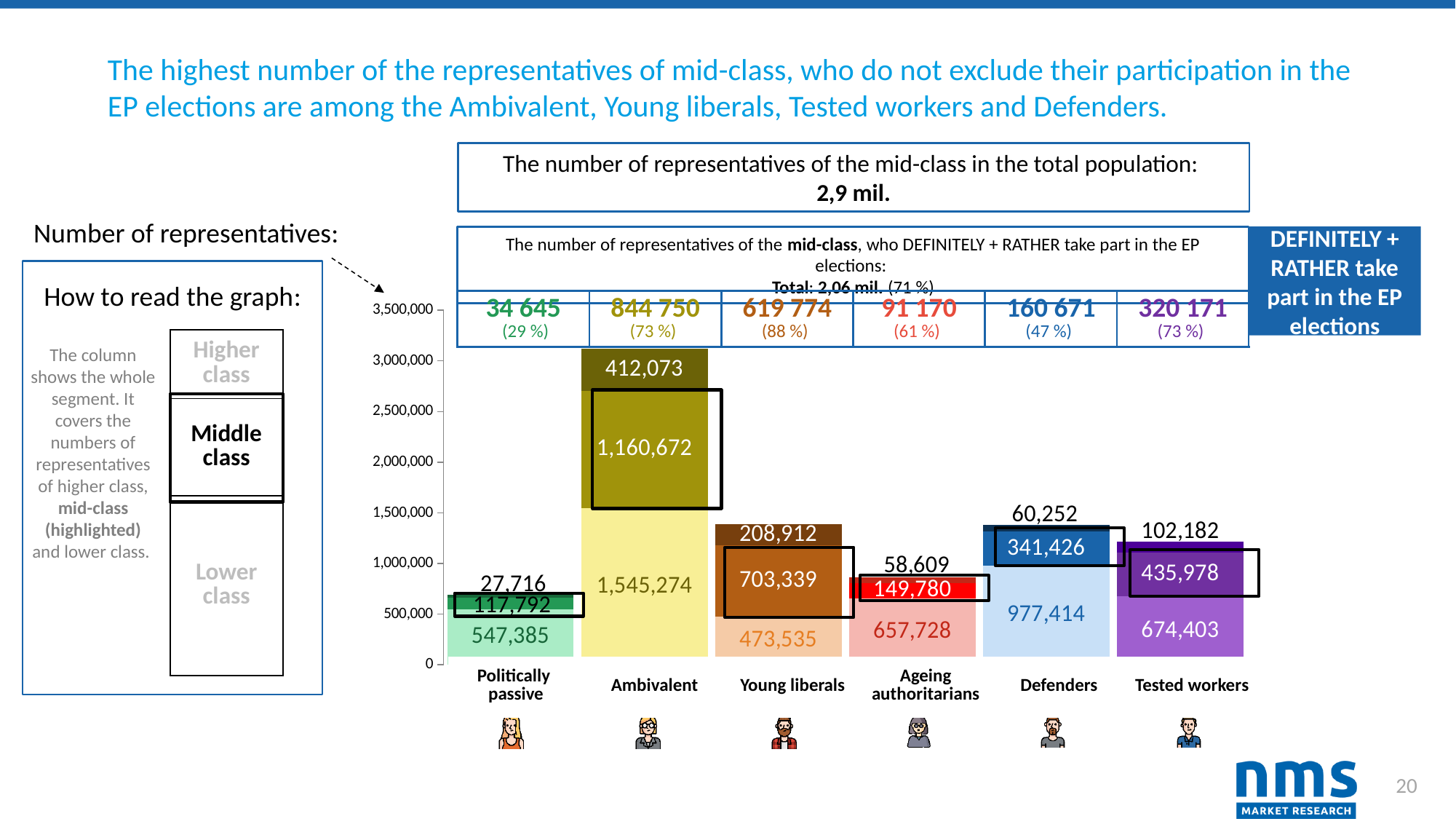
Which segment has the lowest middle-class value? Politically passive What is the higher-class value shown for the Tested workers segment? 102,182 Which is larger, the lower-class value for Ageing authoritarians or the lower-class value for Tested workers? Tested workers What is the total of the stacked bar for Defenders? 1,379,092 What kind of chart is shown on the slide? Stacked bar chart What is the difference between the middle-class values of Young liberals and Tested workers? 267,361 How many segments (categories) are shown on the x axis of the chart? 6 What is the middle-class value shown for the Ambivalent segment? 1,160,672 What is the lower-class value shown for the Defenders segment? 977,414 Which segment has the highest middle-class value? Ambivalent Is the total height of the Ambivalent bar greater or less than 3,000,000? greater According to the table above the chart, what percentage of the mid-class Young liberals definitely or rather take part in the EP elections? 88 %